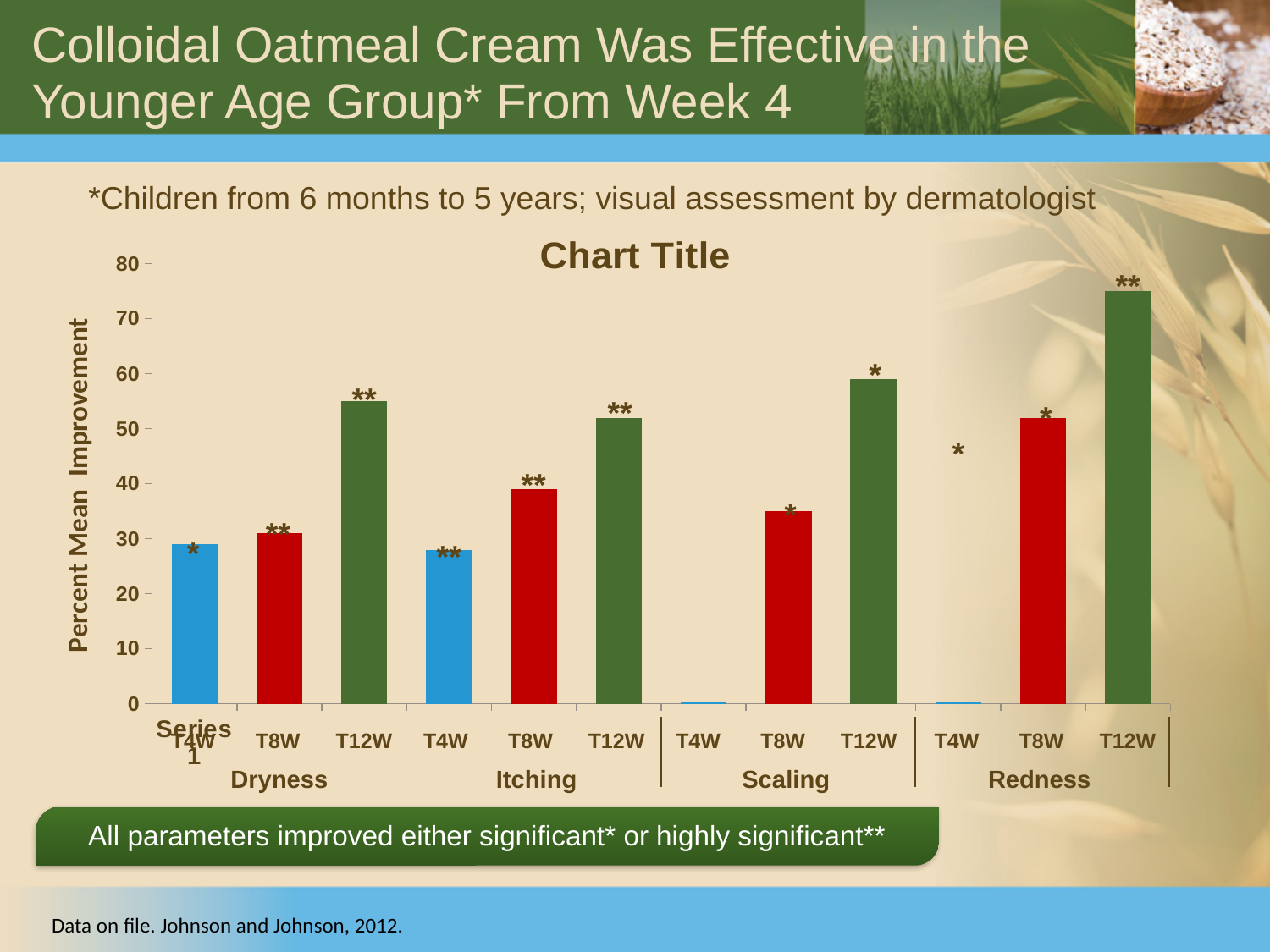
Within the Dryness group, do the values rise or fall from T4W to T12W? rise What is the label on the vertical axis of the chart? Percent Mean Improvement Is the value for Scaling T8W greater or less than 40? less Which bar is the highest in the chart? Redness T12W Which is larger, the T12W value for Scaling or the T12W value for Itching? Scaling How many time points are plotted for each parameter group? 3 Is the value for Dryness T12W greater or less than 50? greater How many parameter groups are shown along the x axis of the chart? 4 What kind of chart is shown on the slide? bar chart Is the value for Redness T12W greater or less than 70? greater Which is larger, the T8W value for Dryness or the T8W value for Itching? Itching